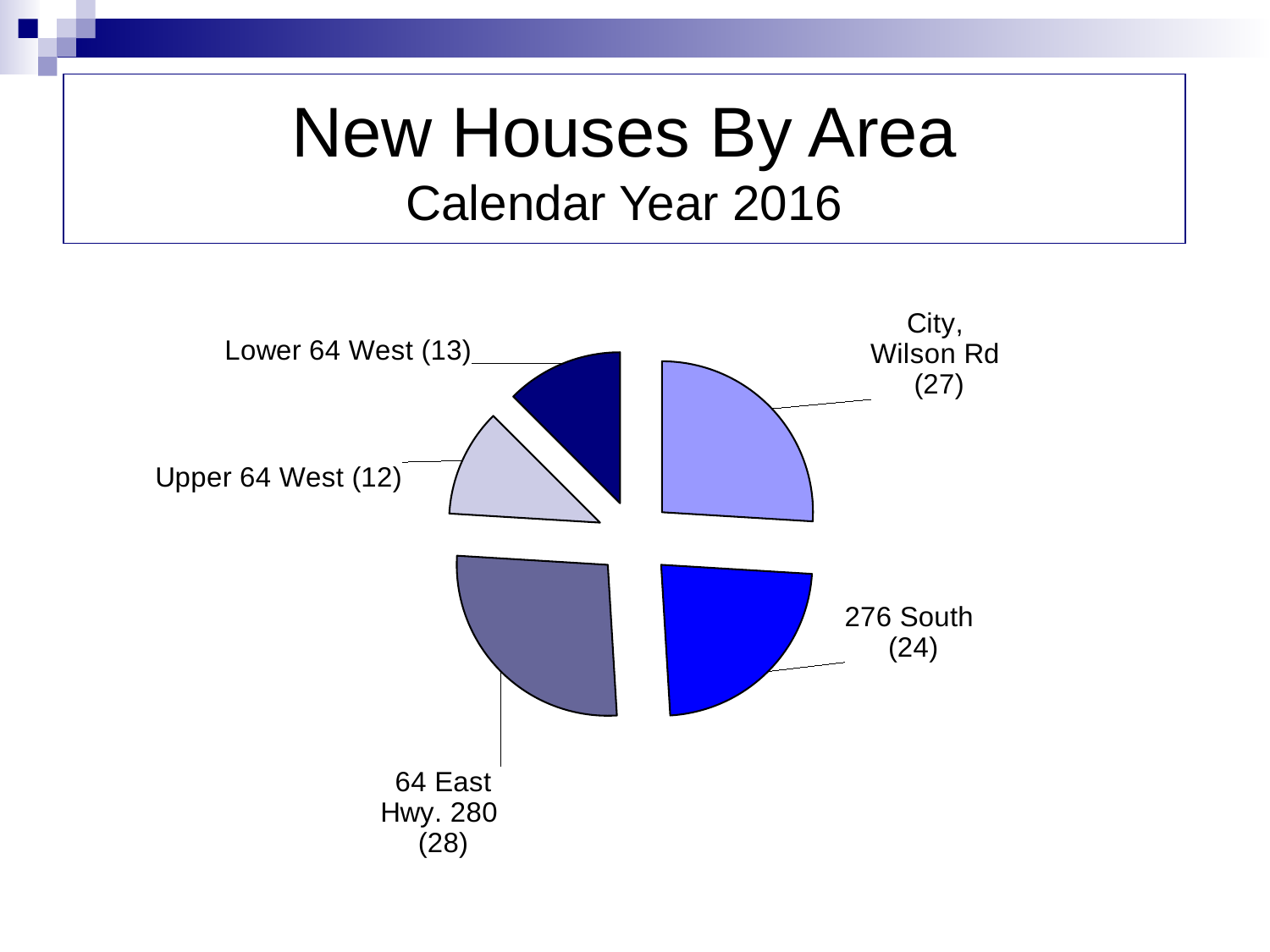
How many areas are shown in the pie chart? 5 What is the difference between the number of new houses in 64 East Hwy. 280 and in Upper 64 West? 16 How many new houses were built in the Lower 64 West area? 13 Which area had the most new houses? 64 East Hwy. 280 Which area had the fewest new houses? Upper 64 West What is the total number of new houses across all areas shown in the chart? 104 How many new houses were built in the Upper 64 West area? 12 Which area had more new houses, City, Wilson Rd or 276 South? City, Wilson Rd How many new houses were built in the City, Wilson Rd area? 27 How many new houses were built in the 276 South area? 24 What type of chart is shown on the slide? Pie chart How many new houses were built in the 64 East Hwy. 280 area? 28